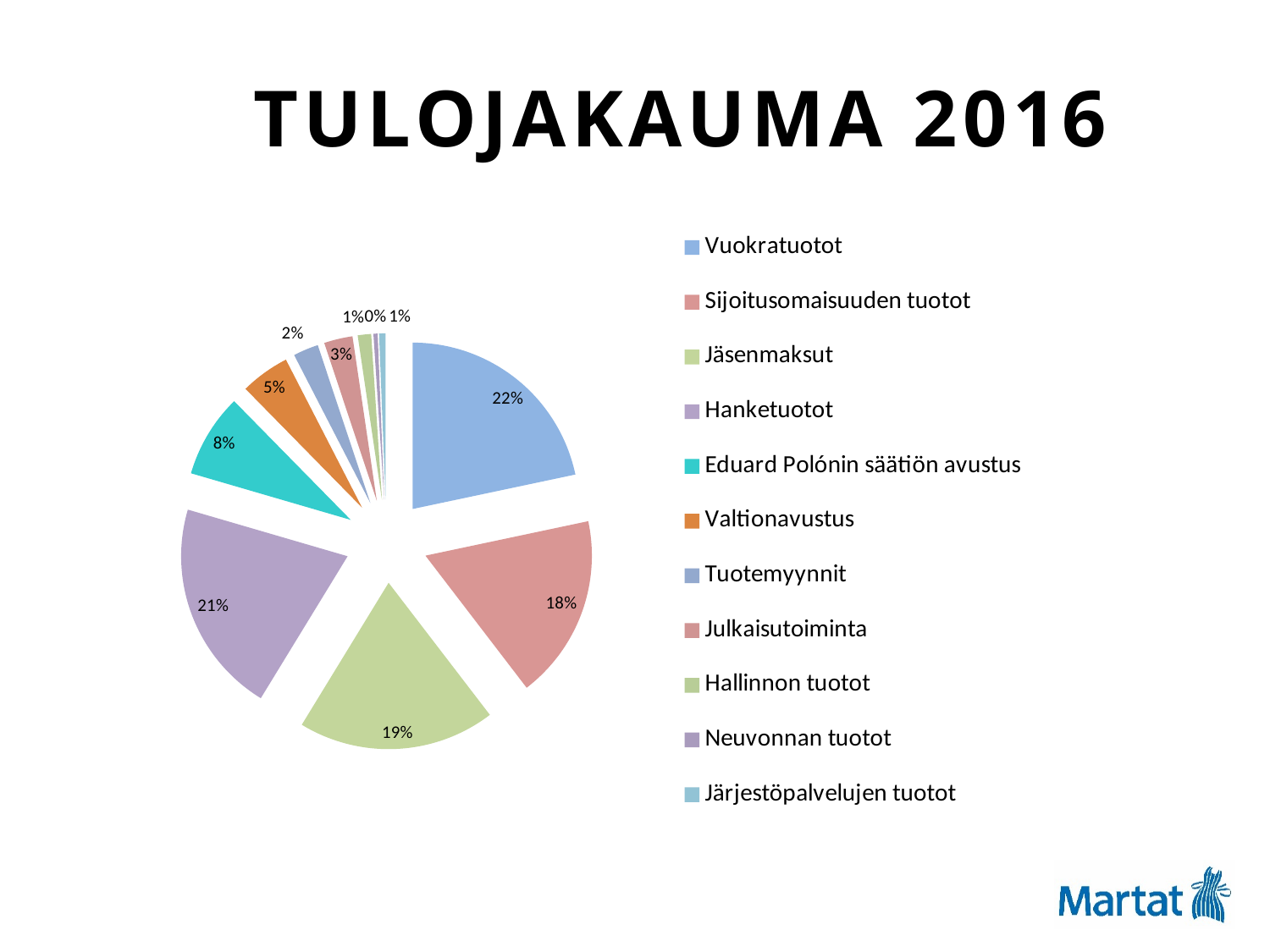
What share of the pie is Vuokratuotot? 22% What is the difference between the share for Vuokratuotot and the share for Eduard Polónin säätiön avustus? 14% What share of the pie is Valtionavustus? 5% What share of the pie is Hanketuotot? 21% How many categories does the legend list? 11 What is the title of the chart? TULOJAKAUMA 2016 What kind of chart is shown on the slide? pie chart Which category has the largest share of the pie? Vuokratuotot Which is larger, the share for Jäsenmaksut or the share for Sijoitusomaisuuden tuotot? Jäsenmaksut